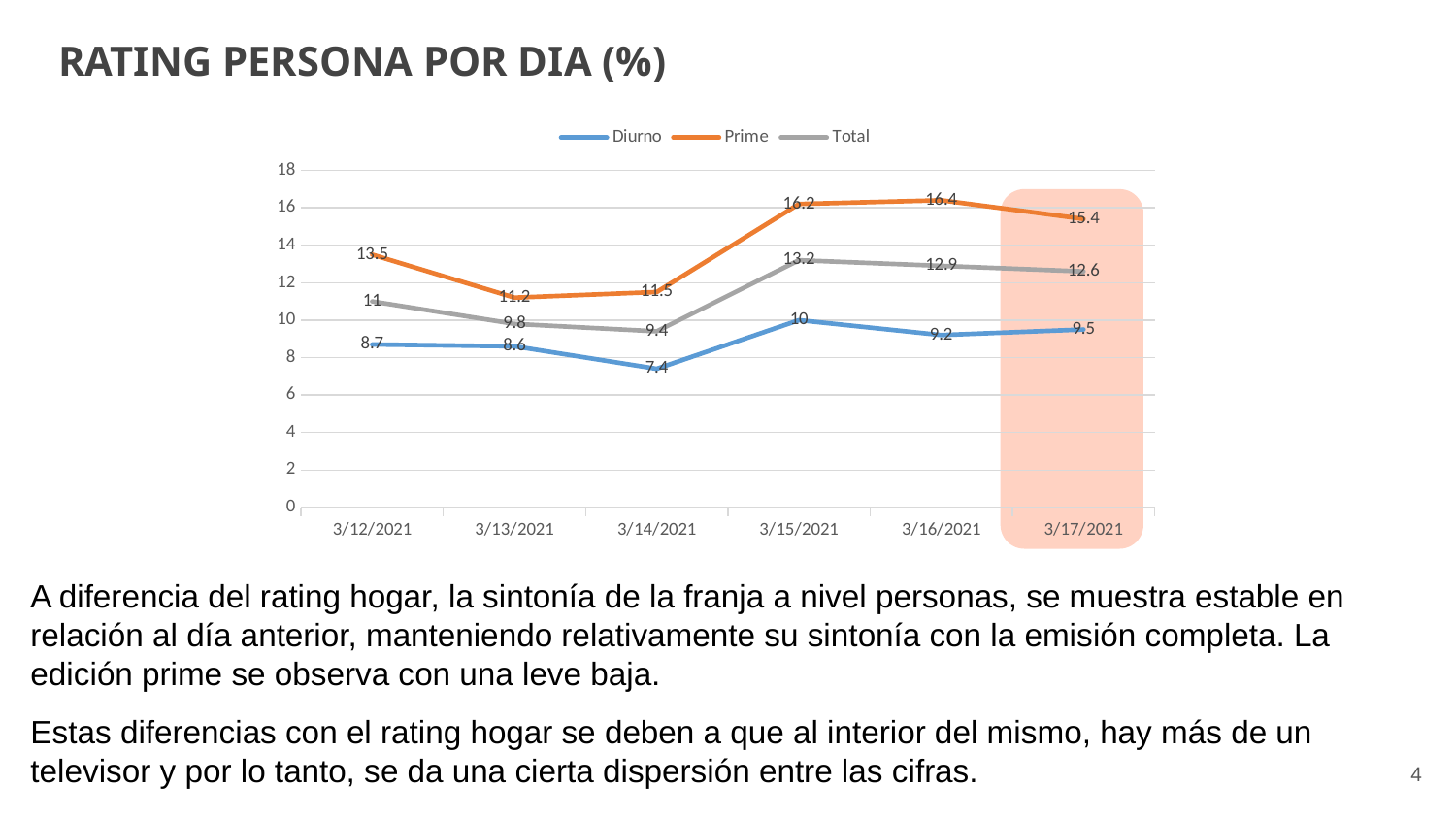
What is the difference between the Prime and Diurno values on 3/15/2021? 6.2 What is the title of the chart? RATING PERSONA POR DIA (%) How many dates are shown on the x axis? 6 Does the Prime series rise or fall from 3/16/2021 to 3/17/2021? Fall What is the Diurno value on 3/14/2021? 7.4 What type of chart is shown on the slide? Line chart Which is larger on 3/13/2021, the Prime value or the Total value? Prime How many series does the legend list? 3 On which date is the Prime series at its highest? 3/16/2021 On which date is the Diurno series at its lowest? 3/14/2021 What is the Total value on 3/17/2021? 12.6 What is the Prime value on 3/16/2021? 16.4